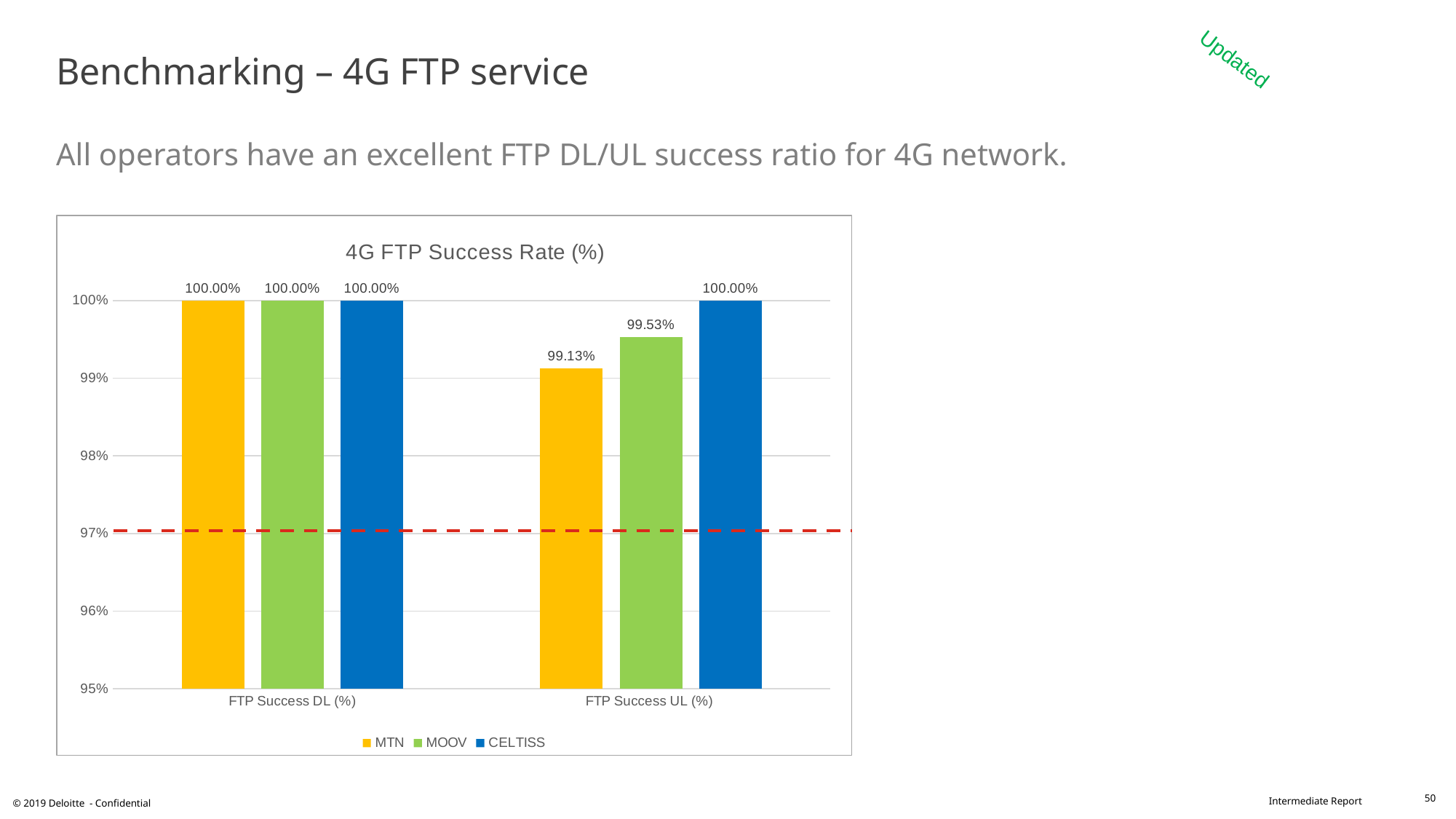
How many series does the legend list? 3 What is the FTP Success UL (%) value for MOOV? 99.53% Which operator has the highest FTP Success UL (%) value? CELTISS What is the FTP Success UL (%) value for MTN? 99.13% What kind of chart is shown on the slide? Bar chart What is the difference between the FTP Success UL (%) values for MOOV and MTN? 0.40% What is the difference between CELTISS's and MTN's FTP Success UL (%) values? 0.87% What is the FTP Success DL (%) value for CELTISS? 100.00% Which operator has the lowest FTP Success UL (%) value? MTN Which is larger: MOOV's FTP Success UL (%) or MTN's FTP Success UL (%)? MOOV's FTP Success UL (%) How many categories are shown on the x axis? 2 What is the title of the chart? 4G FTP Success Rate (%)